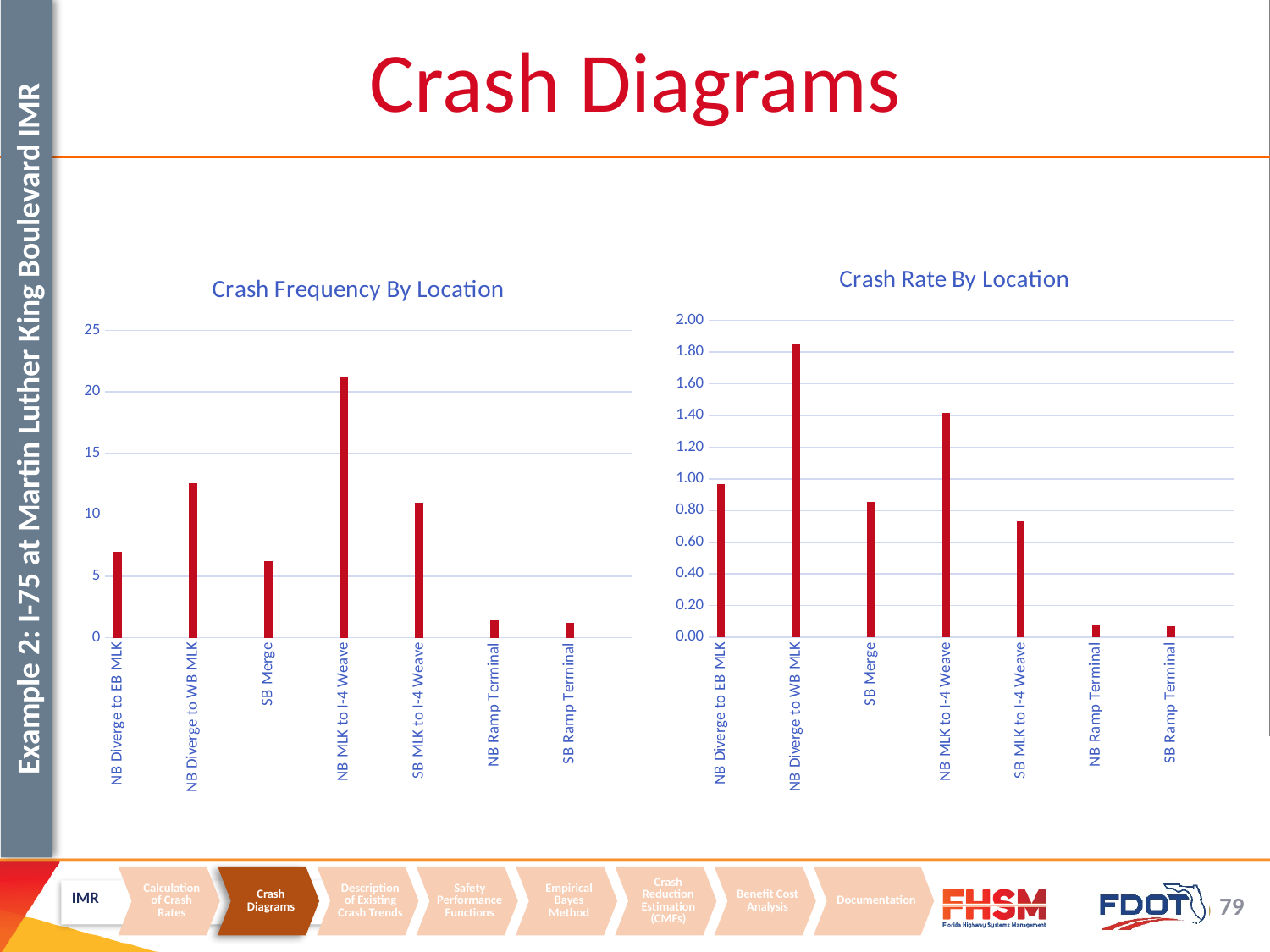
In the Crash Frequency By Location chart, which location has the highest crash frequency? NB MLK to I-4 Weave In the Crash Rate By Location chart, which location has the highest crash rate? NB Diverge to WB MLK In the Crash Frequency By Location chart, is the value for NB Diverge to WB MLK greater or less than 10? greater What type of chart is the Crash Rate By Location chart? Bar chart In the Crash Rate By Location chart, is the value for NB MLK to I-4 Weave greater or less than 1.20? greater In the Crash Rate By Location chart, is the value for SB MLK to I-4 Weave greater or less than 1.00? less In the Crash Frequency By Location chart, which is larger, the value for NB Diverge to EB MLK or the value for SB MLK to I-4 Weave? SB MLK to I-4 Weave In the Crash Rate By Location chart, which is larger, the value for NB Diverge to EB MLK or the value for SB Merge? NB Diverge to EB MLK How many locations are shown in the Crash Frequency By Location chart? 7